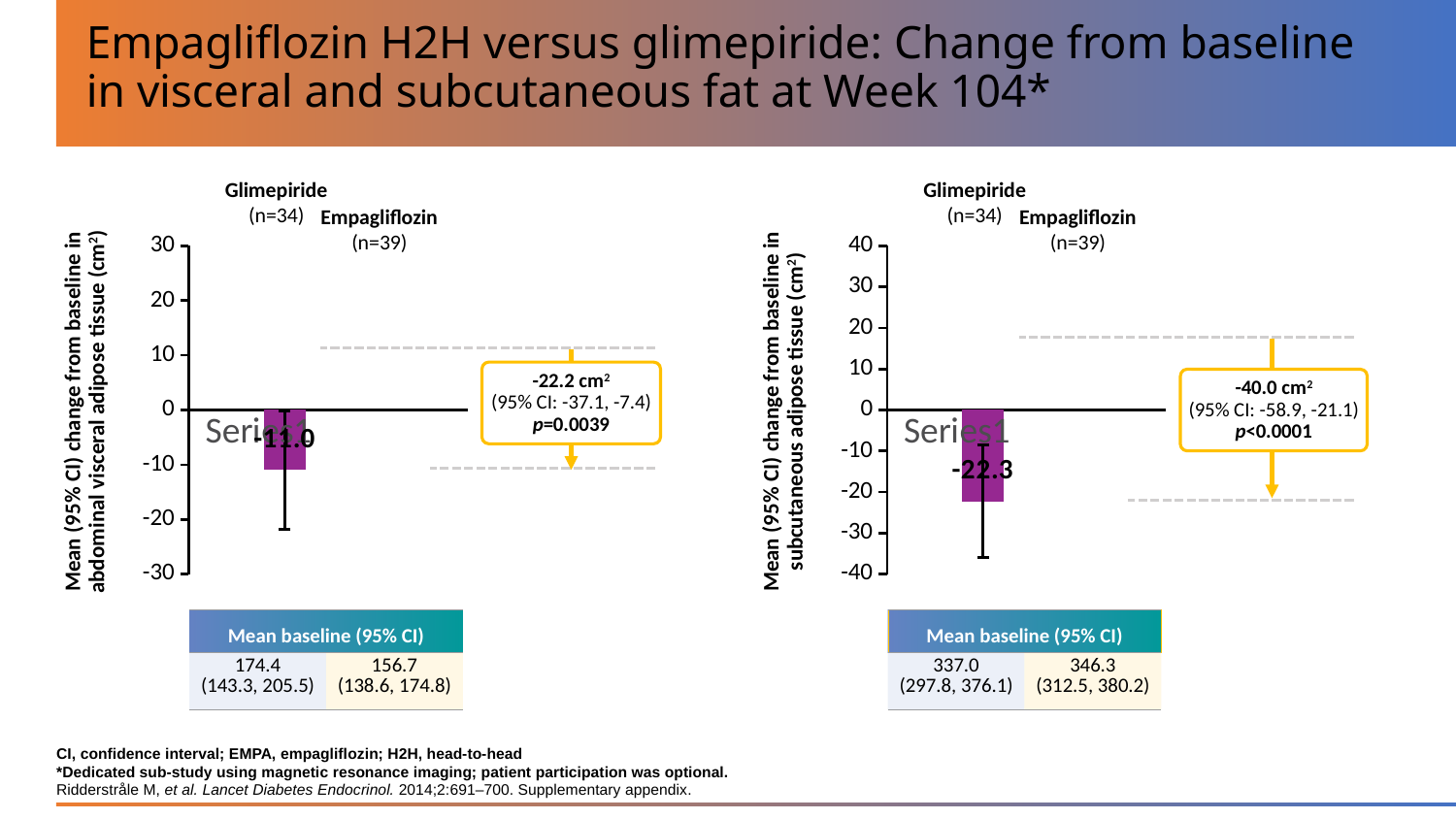
How many bars are plotted in the right chart (subcutaneous adipose tissue)? 1 In the right chart (subcutaneous adipose tissue), is the plotted bar value greater or less than -30? greater In the left chart (abdominal visceral adipose tissue), is the plotted bar value greater or less than 0? less In the right chart (subcutaneous adipose tissue), what value is printed on the plotted bar? -22.3 Which chart shows the lower plotted bar value, the left chart (visceral, -11.0) or the right chart (subcutaneous, -22.3)? the right chart (subcutaneous) In the right chart (subcutaneous adipose tissue), what treatment difference is printed in the callout box? -40.0 cm² In the left chart (abdominal visceral adipose tissue), what treatment difference is printed in the callout box? -22.2 cm² In the left chart (abdominal visceral adipose tissue), what is the highest value shown on the y-axis? 30 What is the difference between the plotted bar value in the left chart (-11.0) and the plotted bar value in the right chart (-22.3)? 11.3 In the right chart (subcutaneous adipose tissue), what p-value is printed in the callout box? p<0.0001 In the left chart (abdominal visceral adipose tissue), what value is printed on the plotted bar? -11.0 What kind of chart is the left chart (abdominal visceral adipose tissue)? bar chart